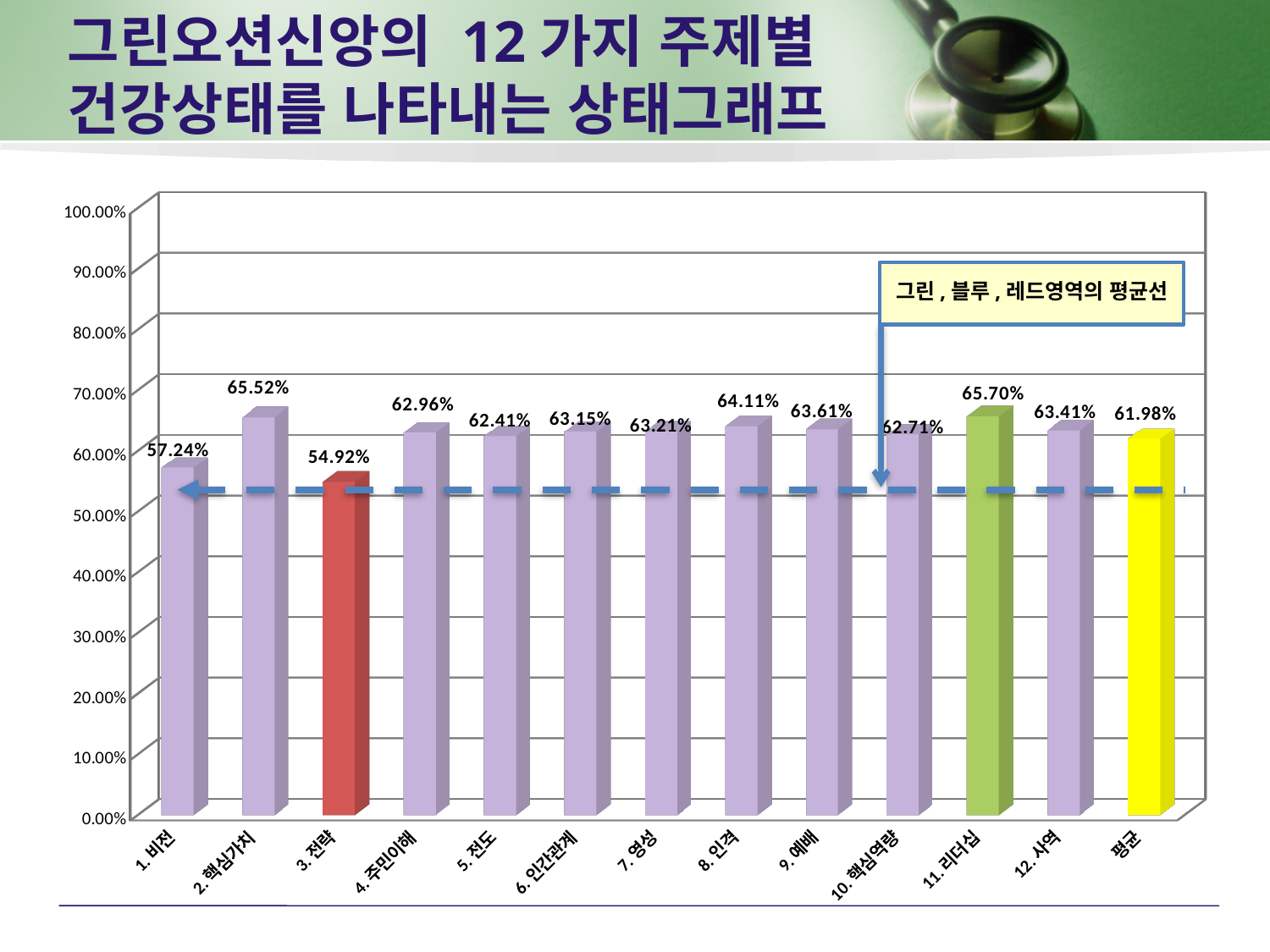
Which category has the highest value? 11. 리더십 Which category has the lowest value? 3. 전략 What is the value of the 평균 bar? 61.98% Which is larger, the value for 8. 인격 or the value for 9. 예배? 8. 인격 What colour is the bar for 3. 전략? red Is the value for 1. 비전 greater or less than 60.00%? less How many bars are plotted in the chart? 13 What kind of chart is shown on the slide? bar chart What is the value for 11. 리더십? 65.70% What is the value for 3. 전략? 54.92% What is the value for 1. 비전? 57.24% What is the difference between the values for 2. 핵심가치 and 3. 전략? 10.60%